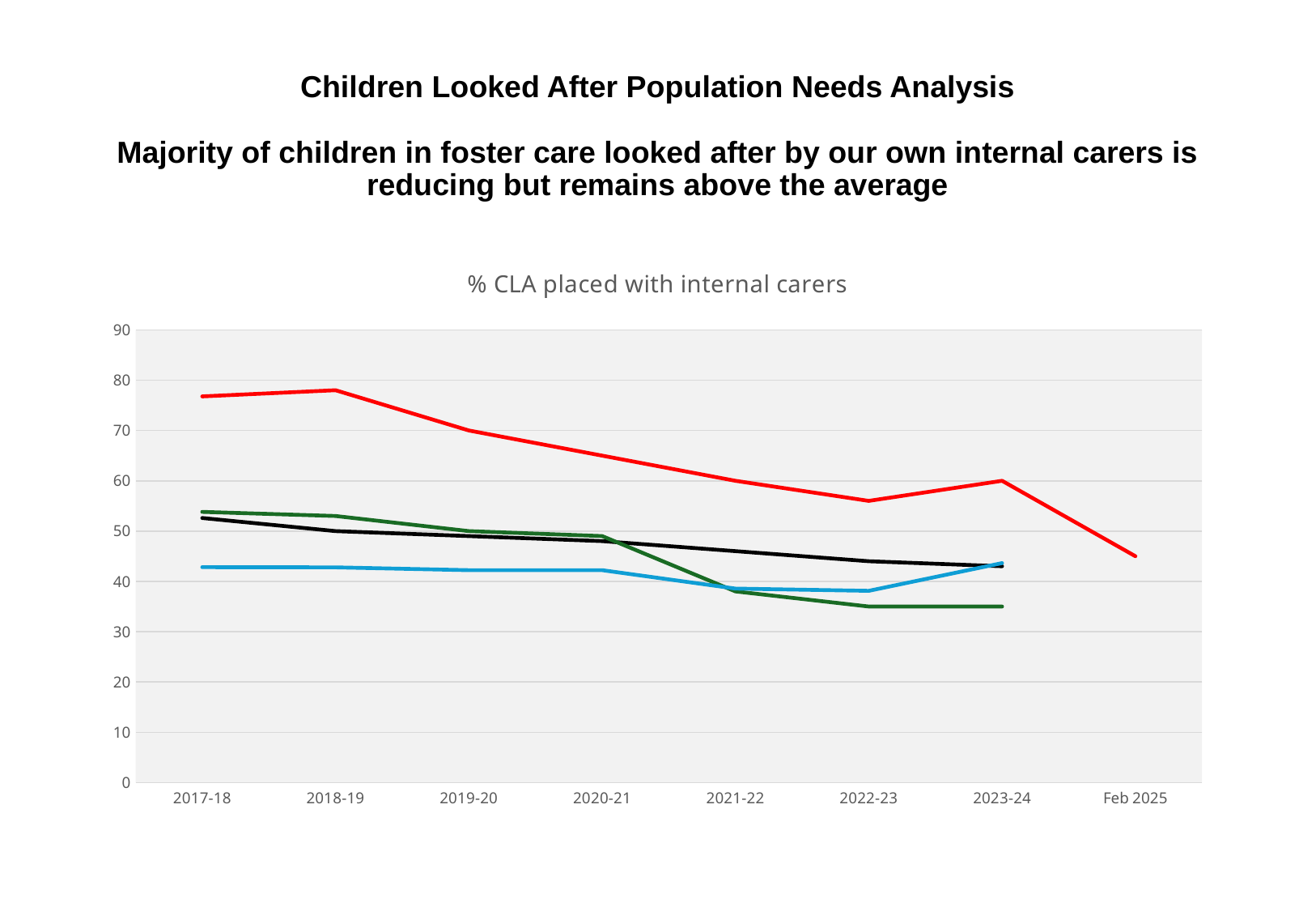
Is the value of the dark green line for 2023-24 greater or less than 40? less In which period does the red line reach its lowest value? Feb 2025 What is the title of the chart? % CLA placed with internal carers What kind of chart is shown on the slide? line chart In 2017-18, which line has the larger value, the red line or the blue line? red line Does the red line rise or fall overall from 2017-18 to Feb 2025? fall Is the value of the blue line for 2017-18 greater or less than 50? less How many lines are plotted on the chart? 4 Is the value of the red line for 2017-18 greater or less than 70? greater How many time periods are shown on the x axis of the chart? 8